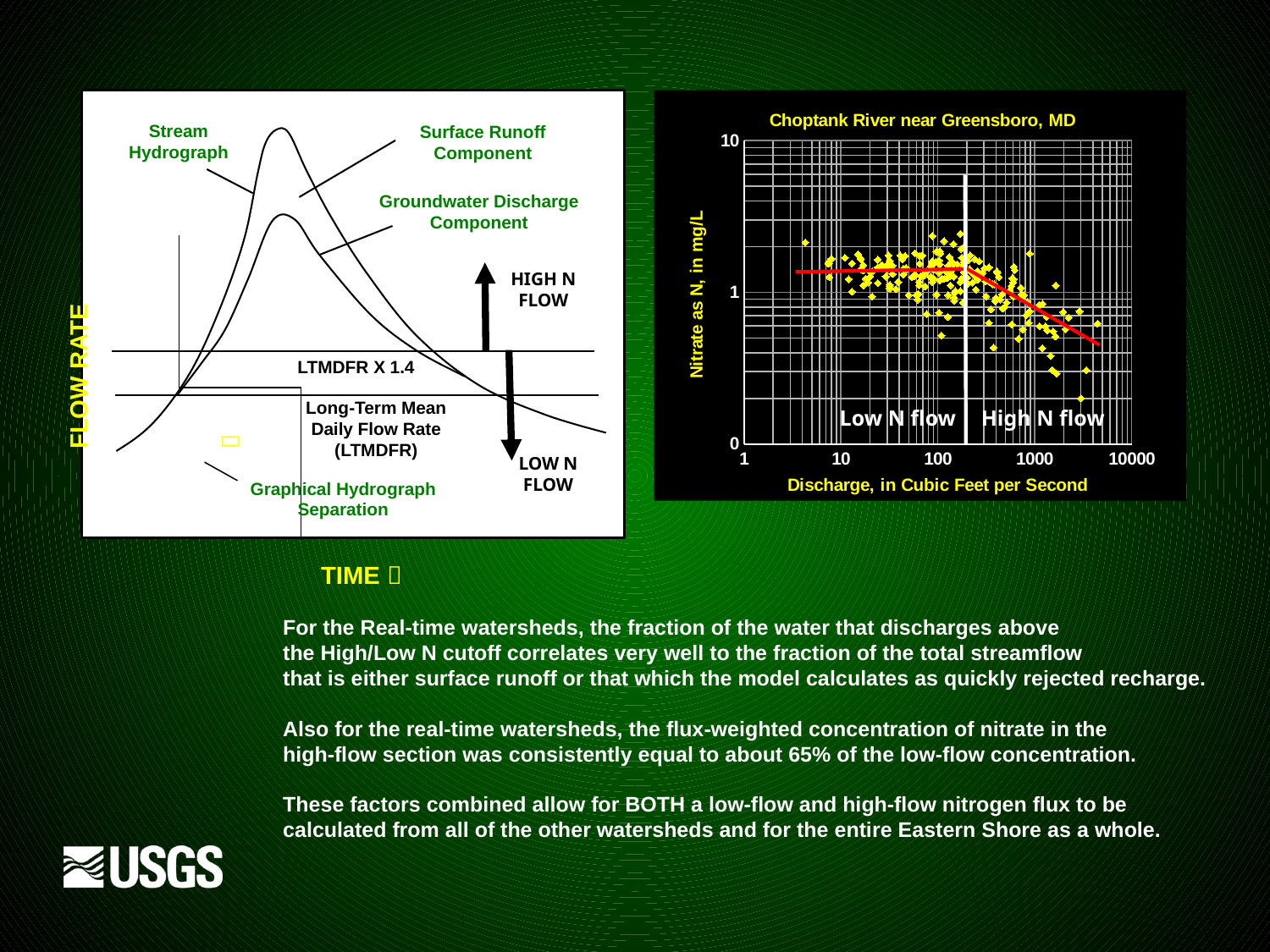
In the right-hand chart, in the 'High N flow' region, does nitrate rise or fall as discharge increases? Fall In the left-hand chart, does the Stream Hydrograph curve rise or fall after its peak as time increases? Fall In the left-hand chart, which curve reaches the higher peak, the Stream Hydrograph or the Groundwater Discharge Component? Stream Hydrograph In the right-hand chart, what is the label of the x axis? Discharge, in Cubic Feet per Second What kind of chart is the left-hand hydrograph diagram? Line chart In the right-hand chart, is the red trend line at a discharge of 10 cubic feet per second greater or less than 1 mg/L? greater In the right-hand chart, is the red trend line at a discharge of 5000 cubic feet per second greater or less than 1 mg/L? less In the right-hand chart, which region has the higher nitrate values along the red line, 'Low N flow' or 'High N flow'? Low N flow In the right-hand chart, how many labelled tick values are shown on the x axis? 5 In the left-hand chart, which horizontal line is higher, 'LTMDFR X 1.4' or 'Long-Term Mean Daily Flow Rate (LTMDFR)'? LTMDFR X 1.4 What is the title of the right-hand chart? Choptank River near Greensboro, MD What kind of chart is the right-hand chart titled 'Choptank River near Greensboro, MD'? Scatter plot